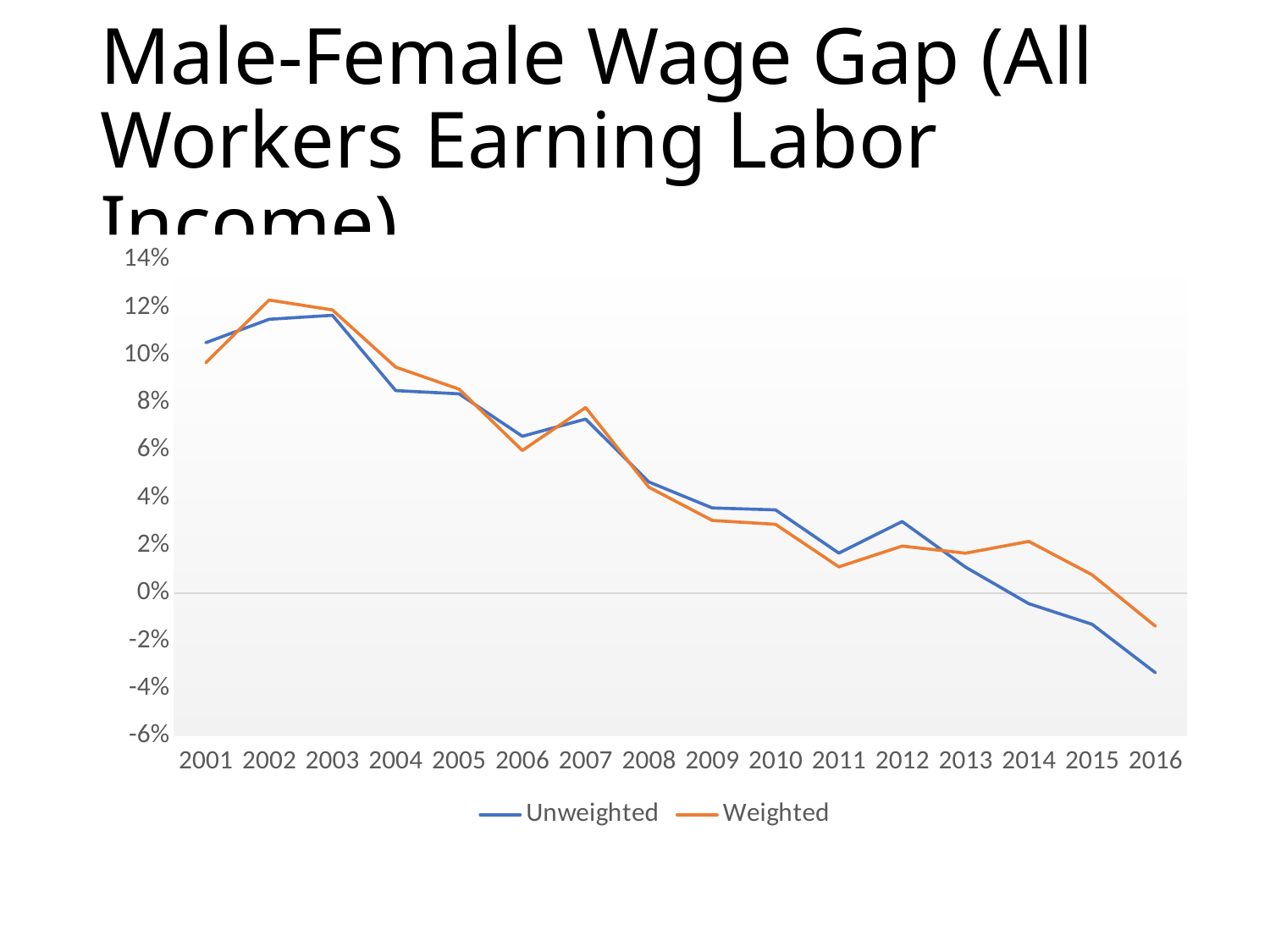
Which colour is used for the Weighted series line? orange Is the Unweighted value for 2001 greater or less than 10%? greater Is the Unweighted value for 2016 greater or less than -2%? less Is the Weighted value for 2016 greater or less than 0%? less How many series does the legend list? 2 In 2014, which series has the higher value, Unweighted or Weighted? Weighted In which year is the Unweighted series at its lowest? 2016 How many years are plotted along the x axis? 16 What kind of chart is shown on the slide? line chart In which year is the Weighted series at its lowest? 2016 Do the values for the Unweighted series generally rise or fall from 2001 to 2016? fall